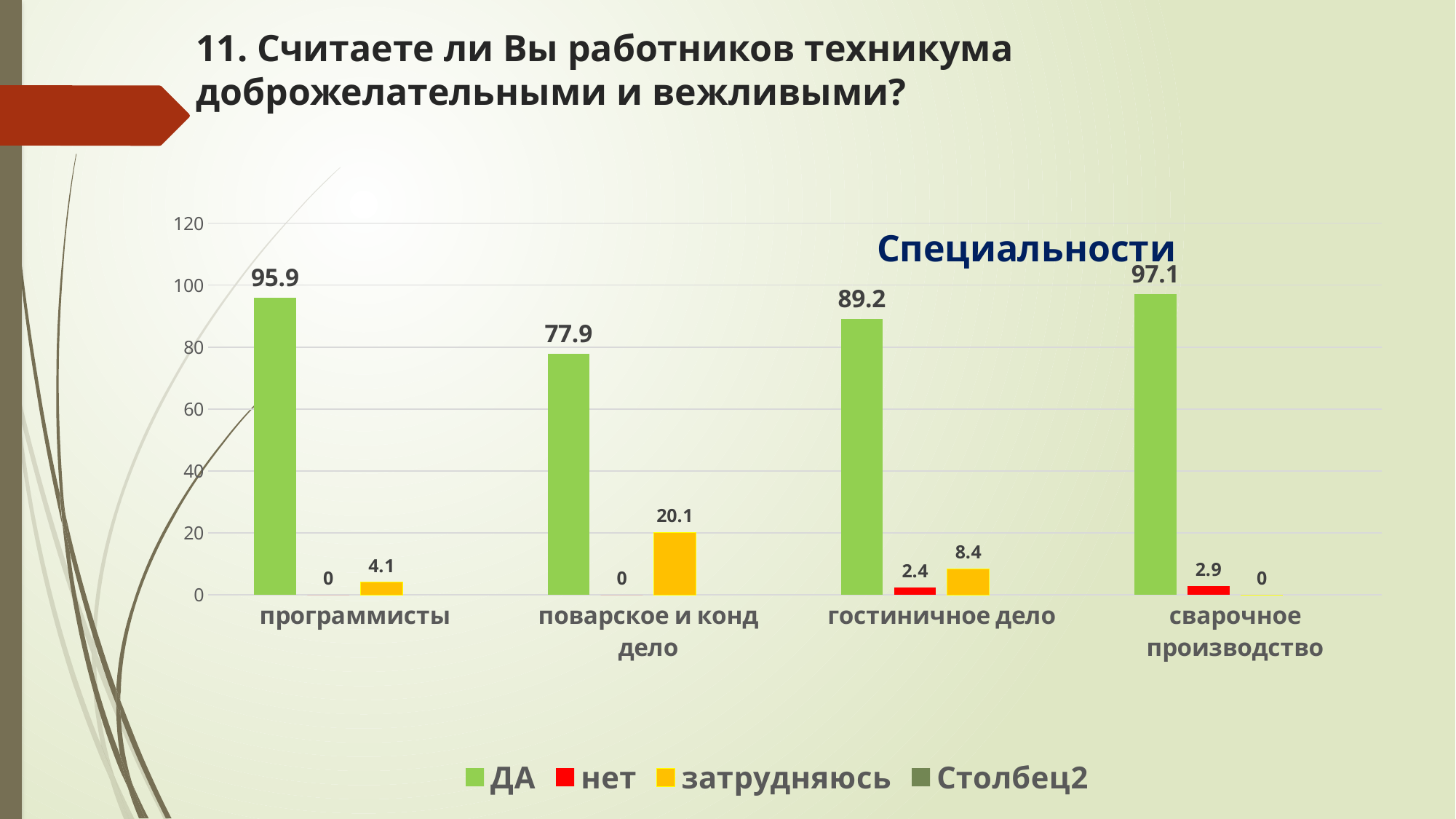
What is the value of the затрудняюсь series for поварское и конд дело? 20.1 What kind of chart is shown on the slide? bar chart How many categories are shown on the x axis? 4 What is the value of the нет series for сварочное производство? 2.9 What is the value of the нет series for гостиничное дело? 2.4 What colour are the bars for the ДА series? green Which is larger: the затрудняюсь value for программисты or for гостиничное дело? гостиничное дело What is the difference between the ДА values for сварочное производство and поварское и конд дело? 19.2 Which category has the lowest value in the ДА series? поварское и конд дело How many series does the legend list? 4 Which category has the highest value in the ДА series? сварочное производство What is the value of the ДА series for программисты? 95.9